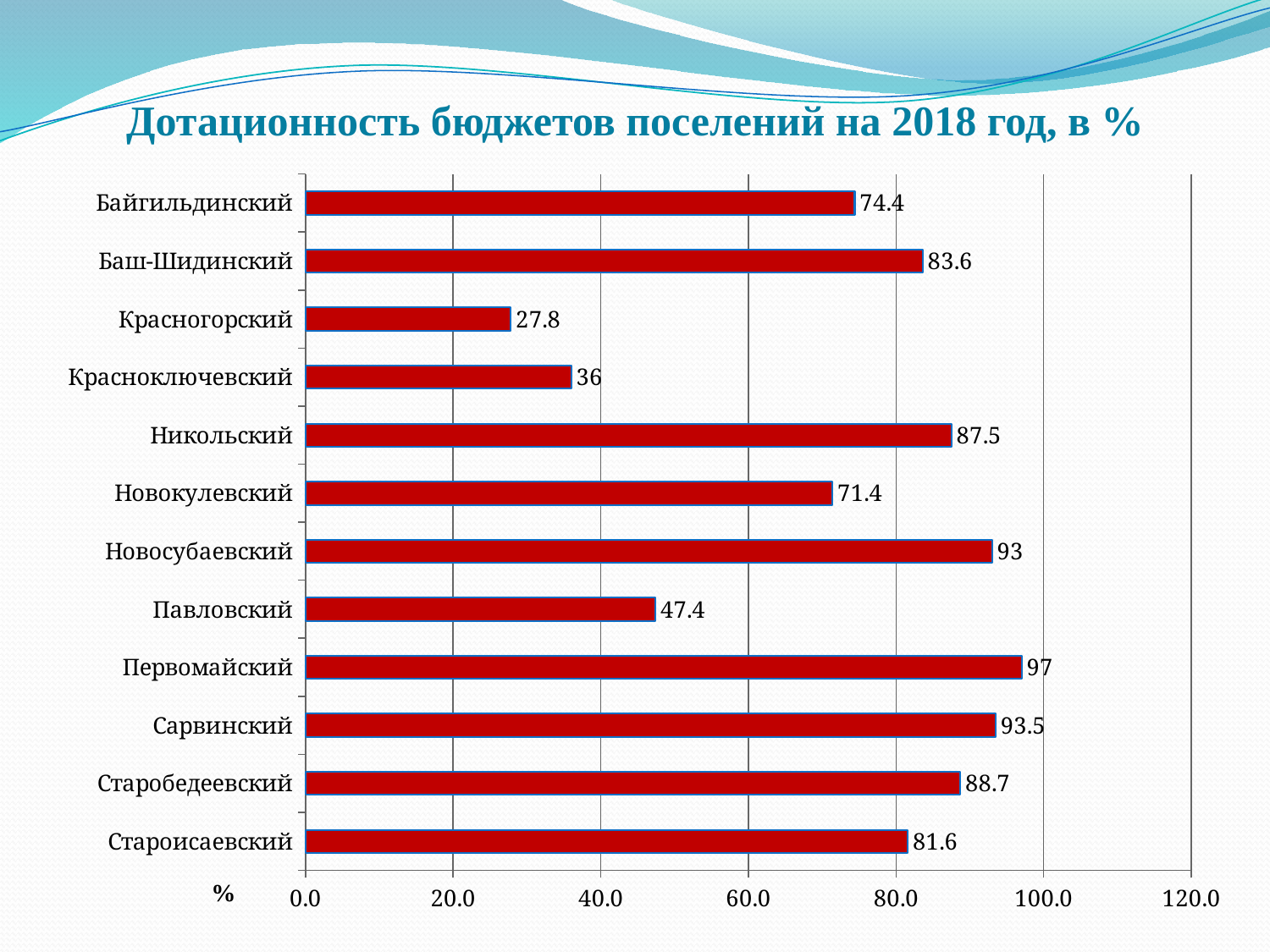
What is the maximum value shown on the horizontal axis? 120.0 Which settlement has the lowest value? Красногорский What kind of chart is shown on the slide? bar chart What is the value for Никольский? 87.5 Is the value for Старобедеевский greater or less than 80.0? greater What is the title of the chart? Дотационность бюджетов поселений на 2018 год, в % What is the value for Староисаевский? 81.6 What is the difference between the values for Баш-Шидинский and Байгильдинский? 9.2 Which is larger, the value for Новокулевский or the value for Краснoключевский? Новокулевский What is the value for Павловский? 47.4 Which settlement has the highest value? Первомайский How many settlements are shown in the chart? 12